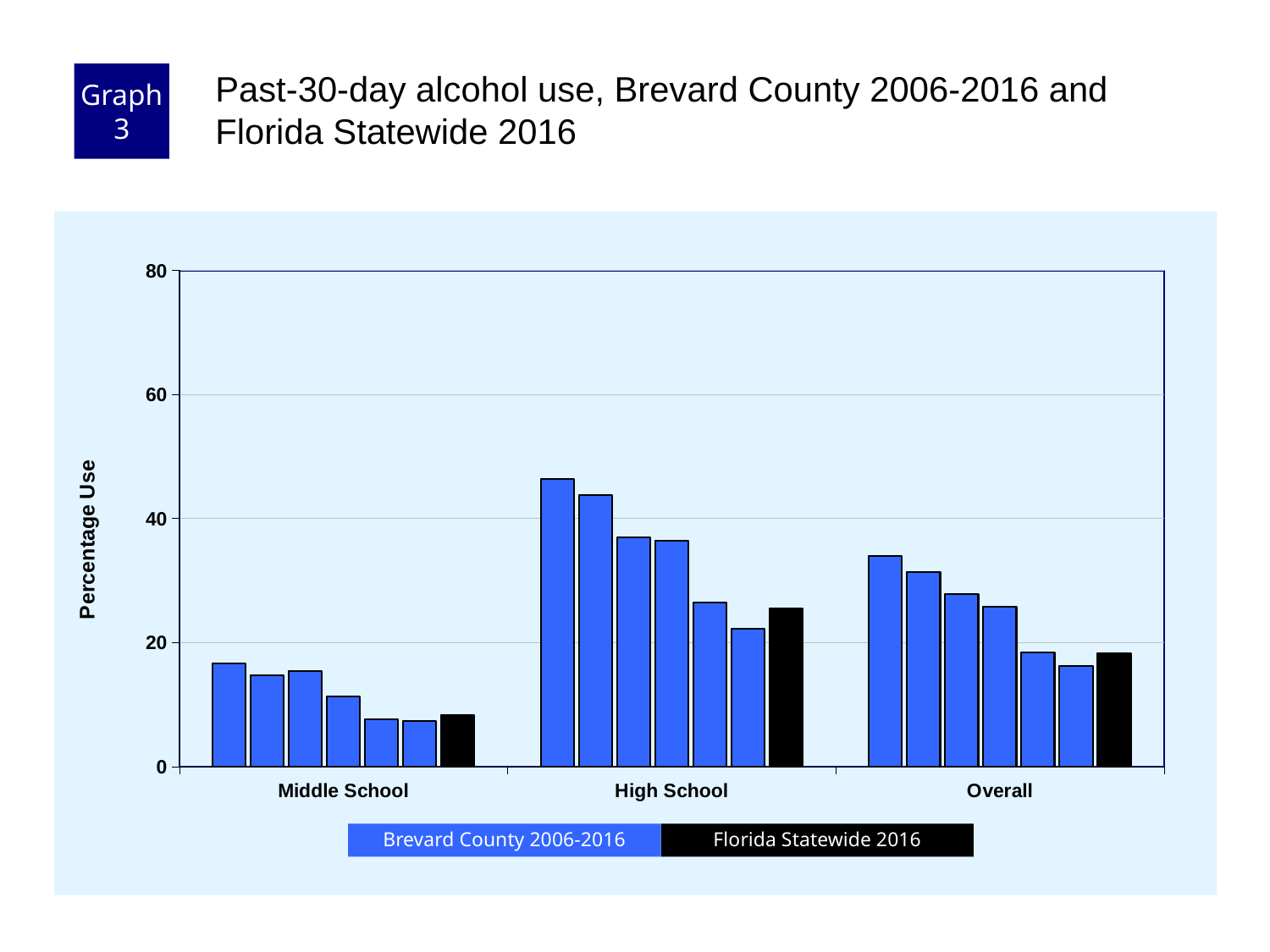
Is the tallest Brevard County bar for High School greater or less than 40? greater Which category has the highest Florida Statewide 2016 bar? High School Is the Florida Statewide 2016 value for High School greater or less than 20? greater Which category has the lowest Florida Statewide 2016 bar? Middle School What kind of chart is shown on the slide? bar chart How many series does the legend list? 2 How many categories are shown on the x axis? 3 Is the Florida Statewide 2016 value for Middle School greater or less than 20? less Within the High School group, do the Brevard County 2006-2016 bars rise or fall from left to right? fall Which is larger, the Florida Statewide 2016 value for High School or for Overall? High School What is the label of the y axis? Percentage Use Which colour represents Florida Statewide 2016 in the legend? black